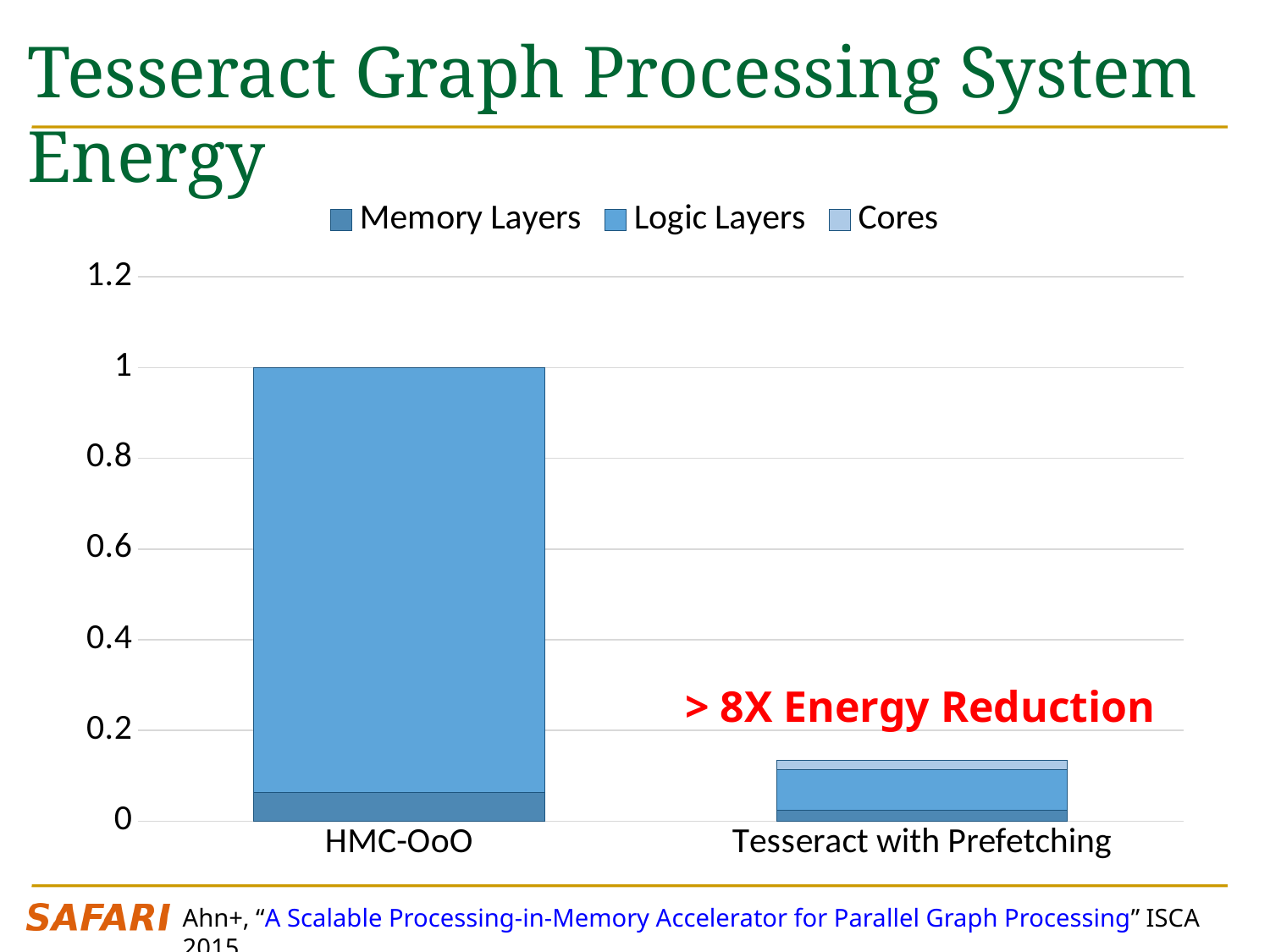
What are the three series listed in the legend? Memory Layers, Logic Layers, Cores Is the Memory Layers value for HMC-OoO greater or less than 0.2? less What does the red annotation on the chart say? > 8X Energy Reduction Which category has the highest total energy? HMC-OoO Do the total bar values rise or fall from left to right along the x axis? fall Which has a larger total bar, HMC-OoO or Tesseract with Prefetching? HMC-OoO What kind of chart is shown on the slide? bar chart How many categories are shown on the x axis? 2 What is the total height of the stacked bar for HMC-OoO? 1 Which category has the lowest total energy? Tesseract with Prefetching Is the total value for Tesseract with Prefetching greater or less than 0.2? less How many series does the legend list? 3